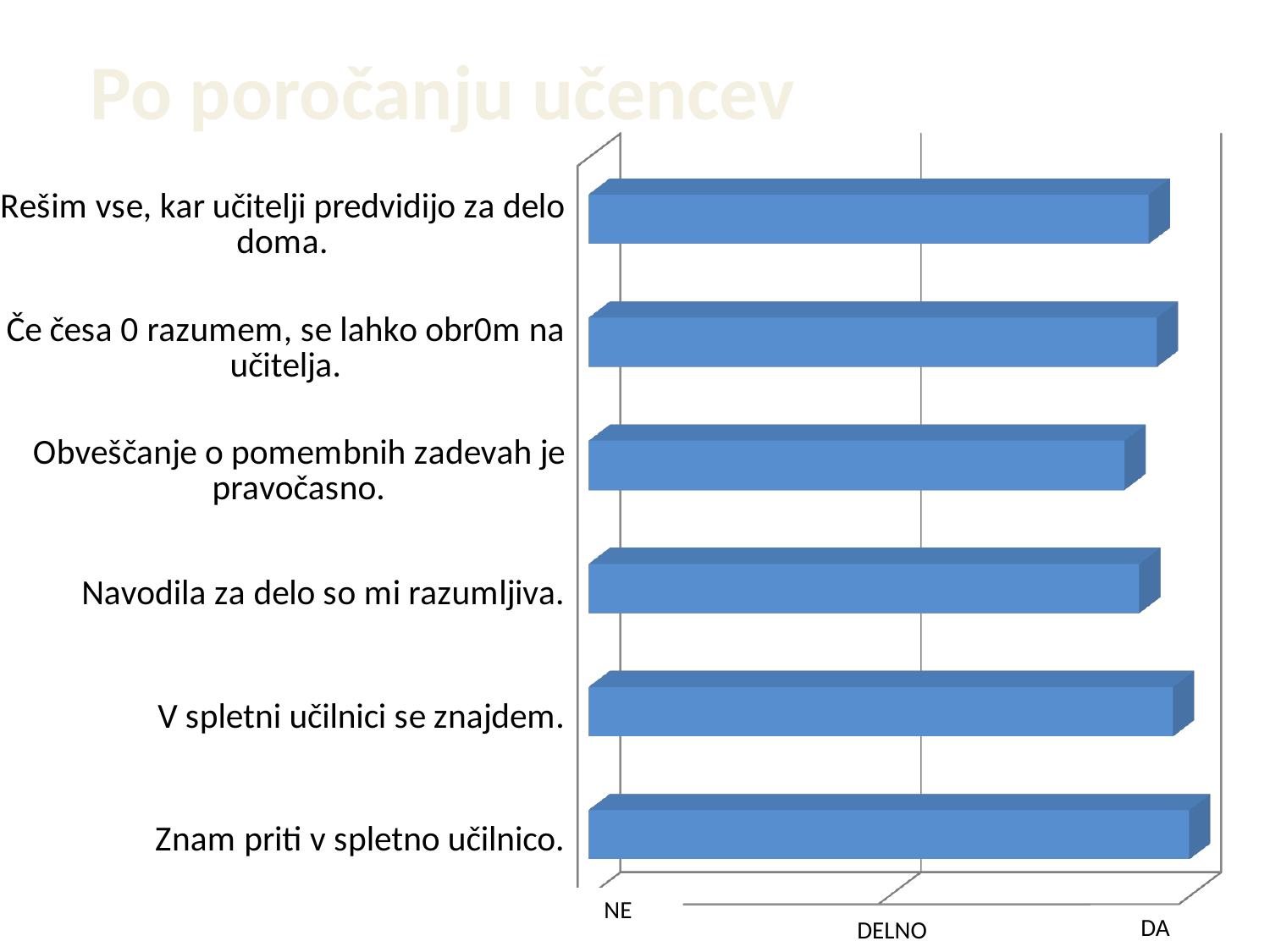
What is the title of the slide containing the chart? Po poročanju učencev Do all the bars in the chart extend past the DELNO mark on the axis? yes What are the three labels shown along the horizontal axis of the chart? NE, DELNO, DA Which bar is longer: "Znam priti v spletno učilnico." or "Obveščanje o pomembnih zadevah je pravočasno."? Znam priti v spletno učilnico. What kind of chart is shown on the slide? bar chart Which bar is longer: "V spletni učilnici se znajdem." or "Obveščanje o pomembnih zadevah je pravočasno."? V spletni učilnici se znajdem. Is the bar for "Rešim vse, kar učitelji predvidijo za delo doma." closer to DA or to NE? DA How many statements (categories) are plotted in the chart? 6 Is the bar for "Navodila za delo so mi razumljiva." closer to DA or to DELNO on the axis? DA